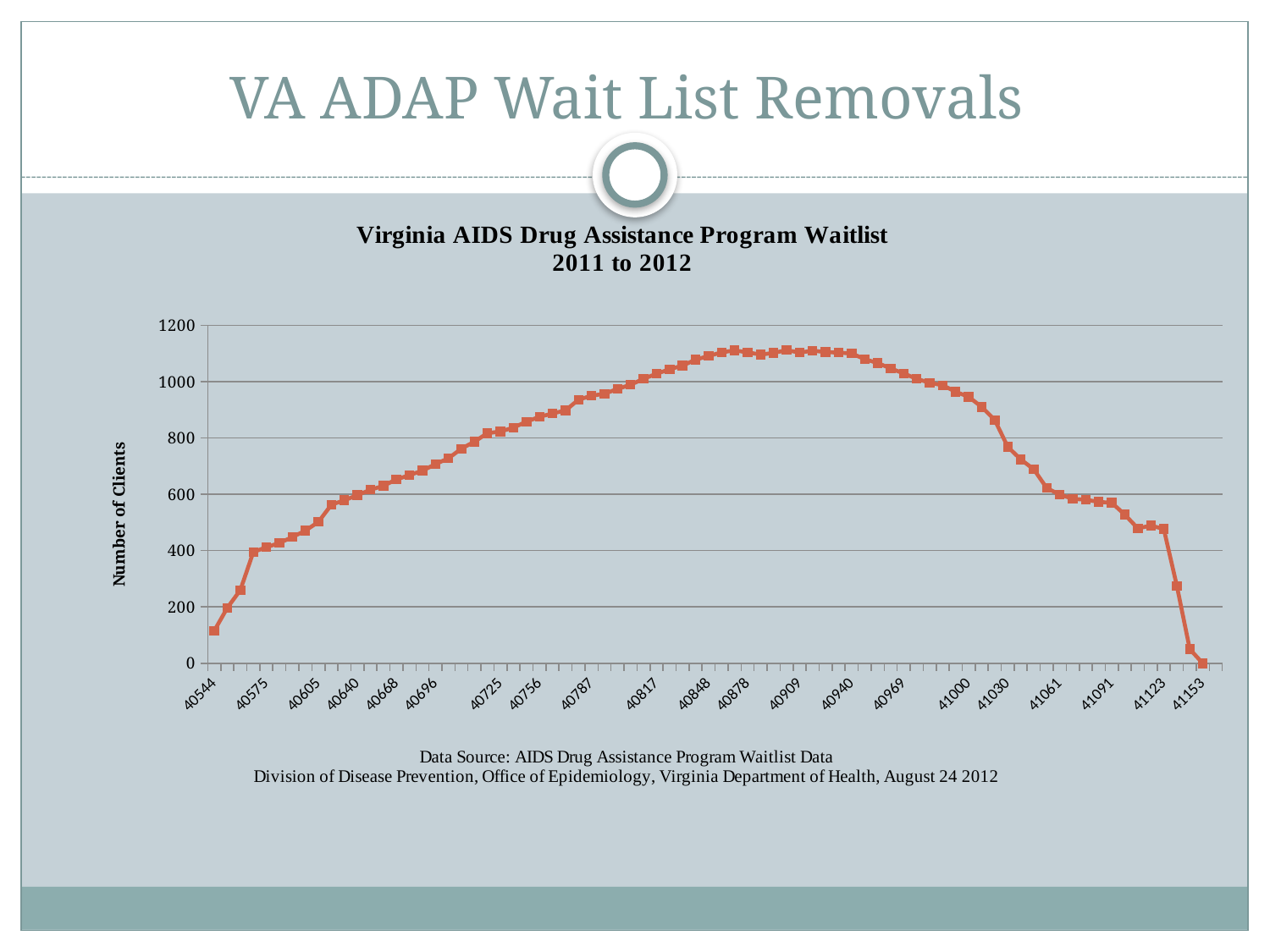
Is the value at 40544 greater or less than 200? less Which is larger, the value at 40909 or the value at 40544? 40909 Is the value at 40605 greater or less than 600? less What is the title of the chart? Virginia AIDS Drug Assistance Program Waitlist 2011 to 2012 Is the value at 40787 greater or less than 800? greater Do the values rise or fall along the x axis between 40544 and 40878? rise What kind of chart is shown on the slide? line chart Do the values rise or fall along the x axis between 40940 and 41153? fall What is the label on the vertical axis of the chart? Number of Clients